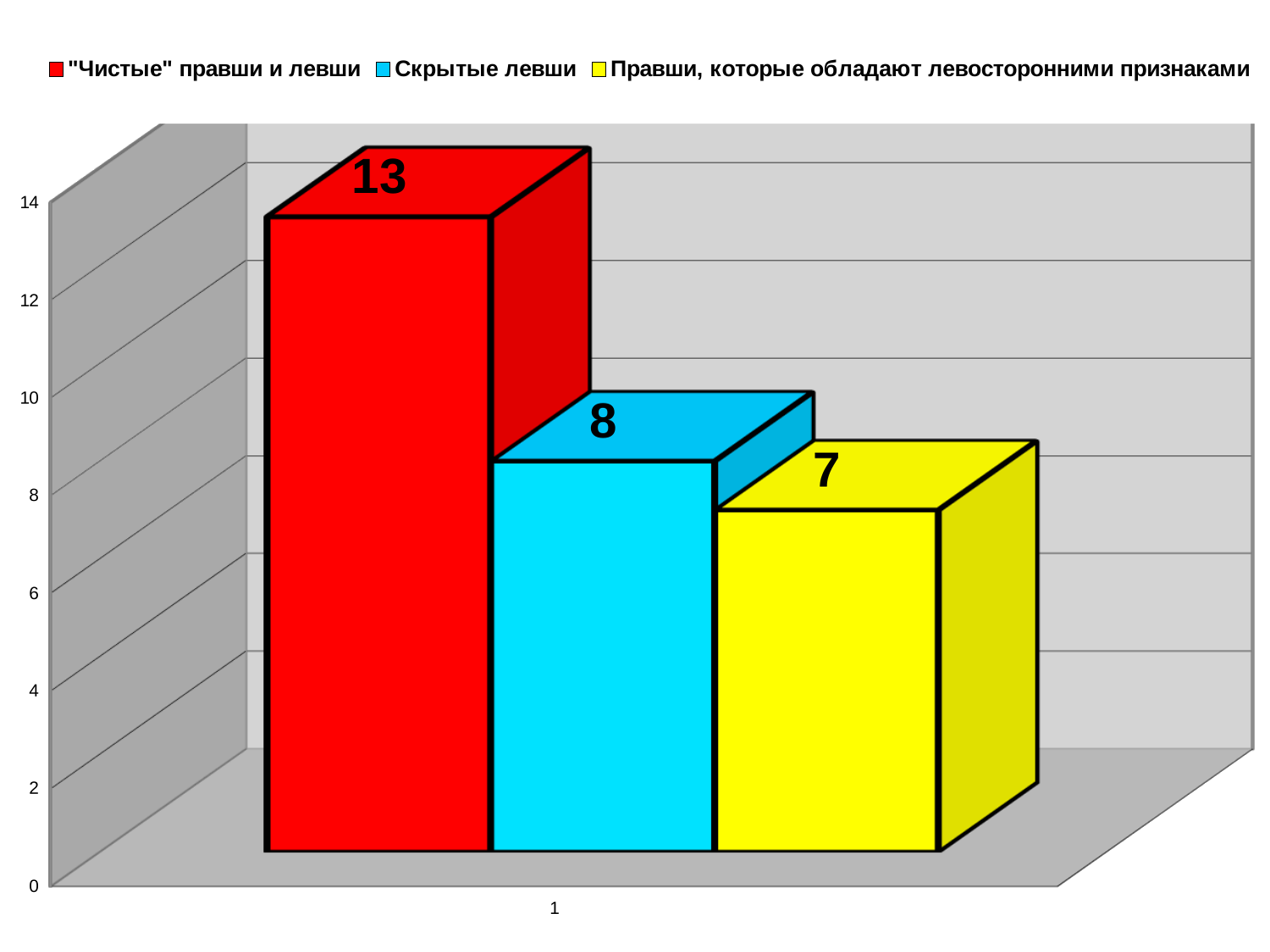
Which is larger, the value for "Чистые" правши и левши or the value for Правши, которые обладают левосторонними признаками? "Чистые" правши и левши Is the value for "Чистые" правши и левши greater or less than 10? greater Which series has the highest value? "Чистые" правши и левши What is the value for Правши, которые обладают левосторонними признаками? 7 What colour is the bar for Скрытые левши? blue What is the difference between the values for "Чистые" правши и левши and Скрытые левши? 5 Which series has the lowest value? Правши, которые обладают левосторонними признаками What is the value for "Чистые" правши и левши? 13 How many series does the legend list? 3 What is the value for Скрытые левши? 8 What kind of chart is shown on the slide? bar chart What is the difference between the values for Скрытые левши and Правши, которые обладают левосторонними признаками? 1